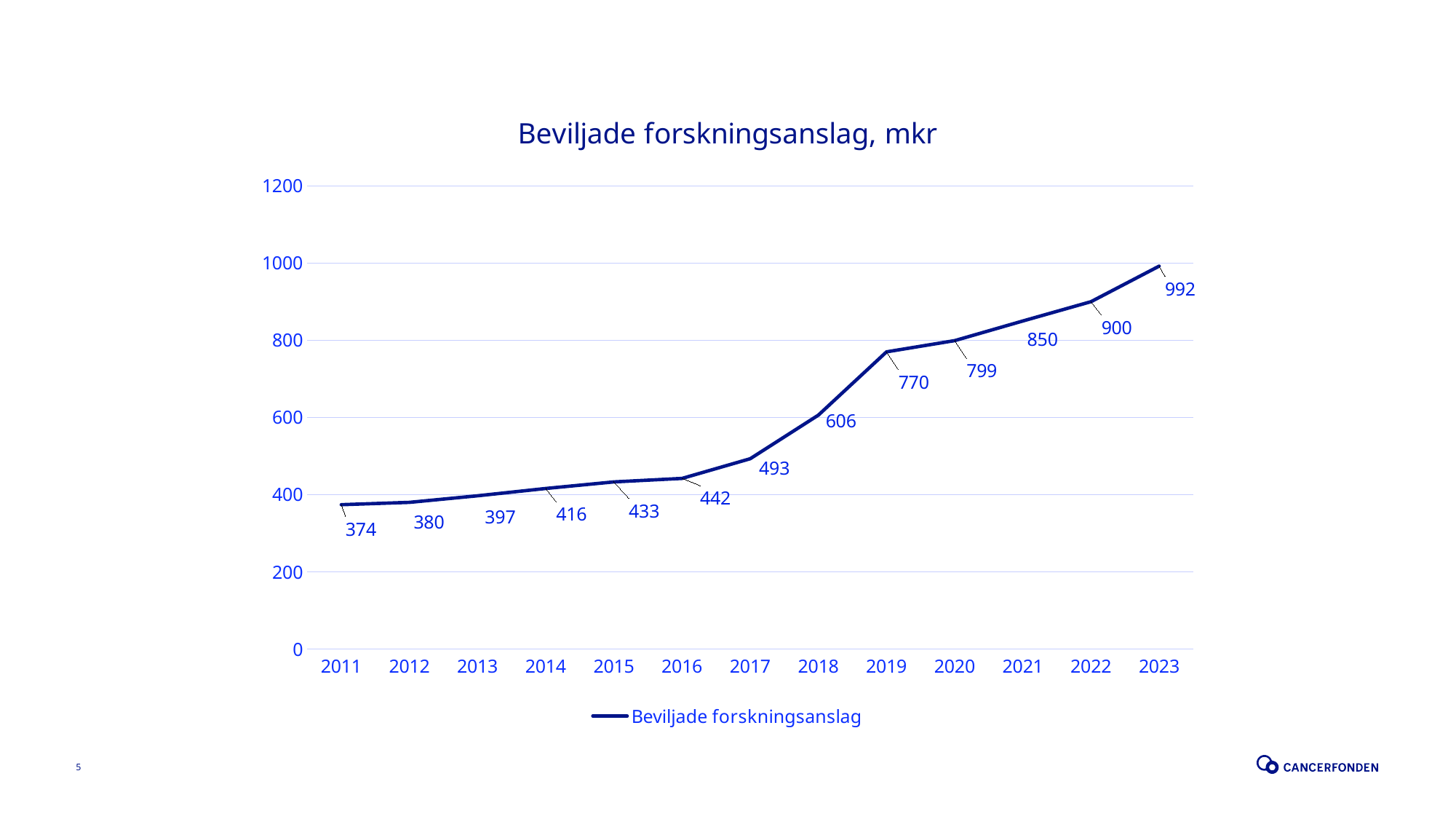
Which year has the lowest value? 2011 What is the value for 2011? 374 Which year has the highest value? 2023 What kind of chart is this? line chart Is the value for 2021 greater or less than 800? greater How many years are plotted on the x axis? 13 What is the value for 2019? 770 What is the value for 2023? 992 What is the difference between the values for 2023 and 2022? 92 What is the difference between the values for 2019 and 2018? 164 Do the values rise or fall from 2011 to 2023? rise Which is larger, the value for 2017 or the value for 2016? 2017